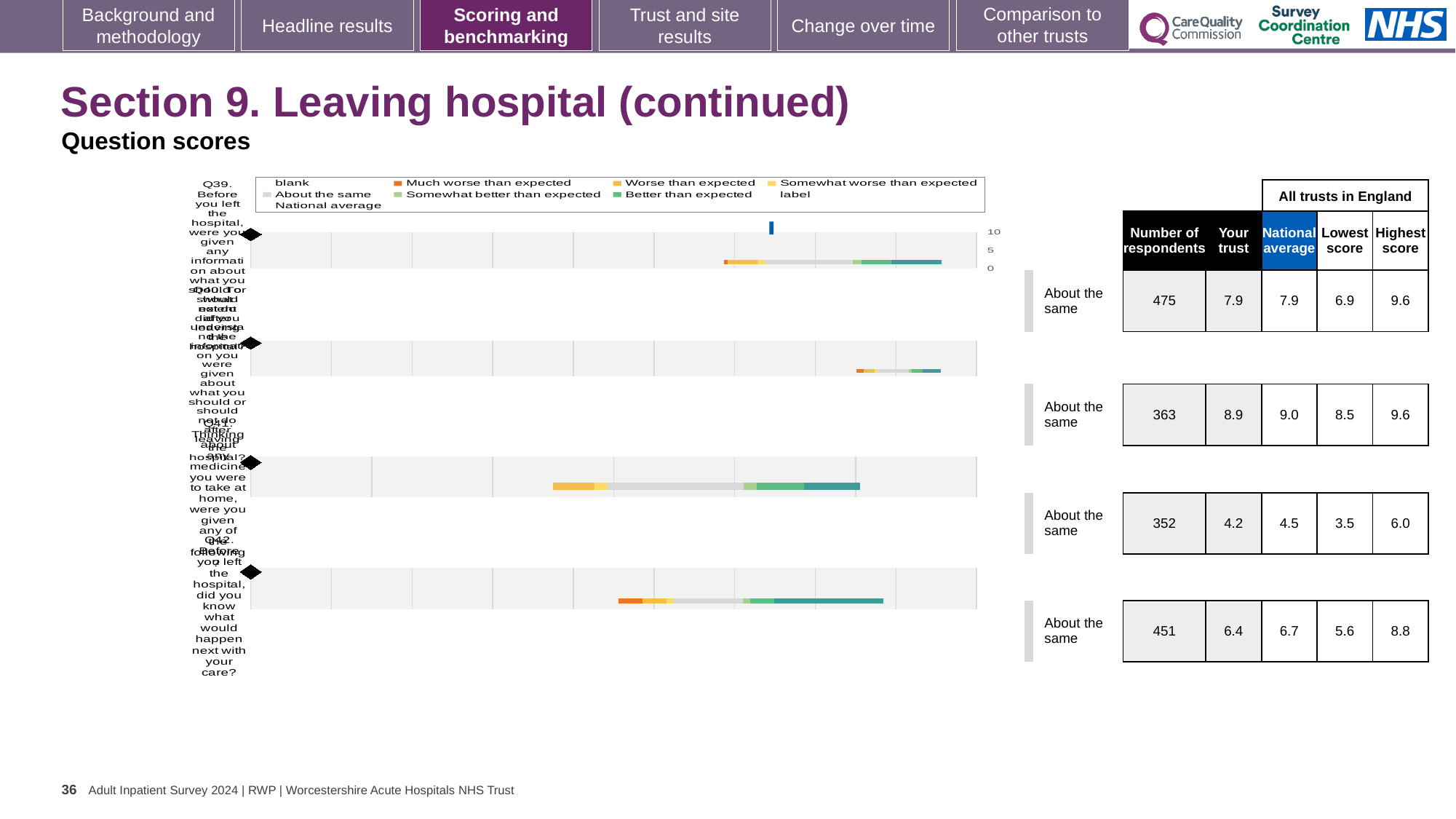
Which question has the highest 'Your trust' score? Q40 What is the number of respondents for Q42 (did you know what would happen next with your care)? 451 Which question has the lowest 'Your trust' score? Q41 How many questions (rows) are plotted in the chart on this slide? 4 What is the lowest score among all trusts in England for Q41? 3.5 What is the national average score for Q41 (medicine to take at home)? 4.5 What is the 'Your trust' score for Q39 (information about what you should or should not do after leaving hospital)? 7.9 What benchmark category is shown for each of the four questions on this slide? About the same What is the highest score among all trusts in England for Q40? 9.6 What is the difference between the national average and the 'Your trust' score for Q42? 0.3 What kind of chart is used to show the question scores on this slide? bar chart Which is larger for Q40: the 'Your trust' score or the national average? national average